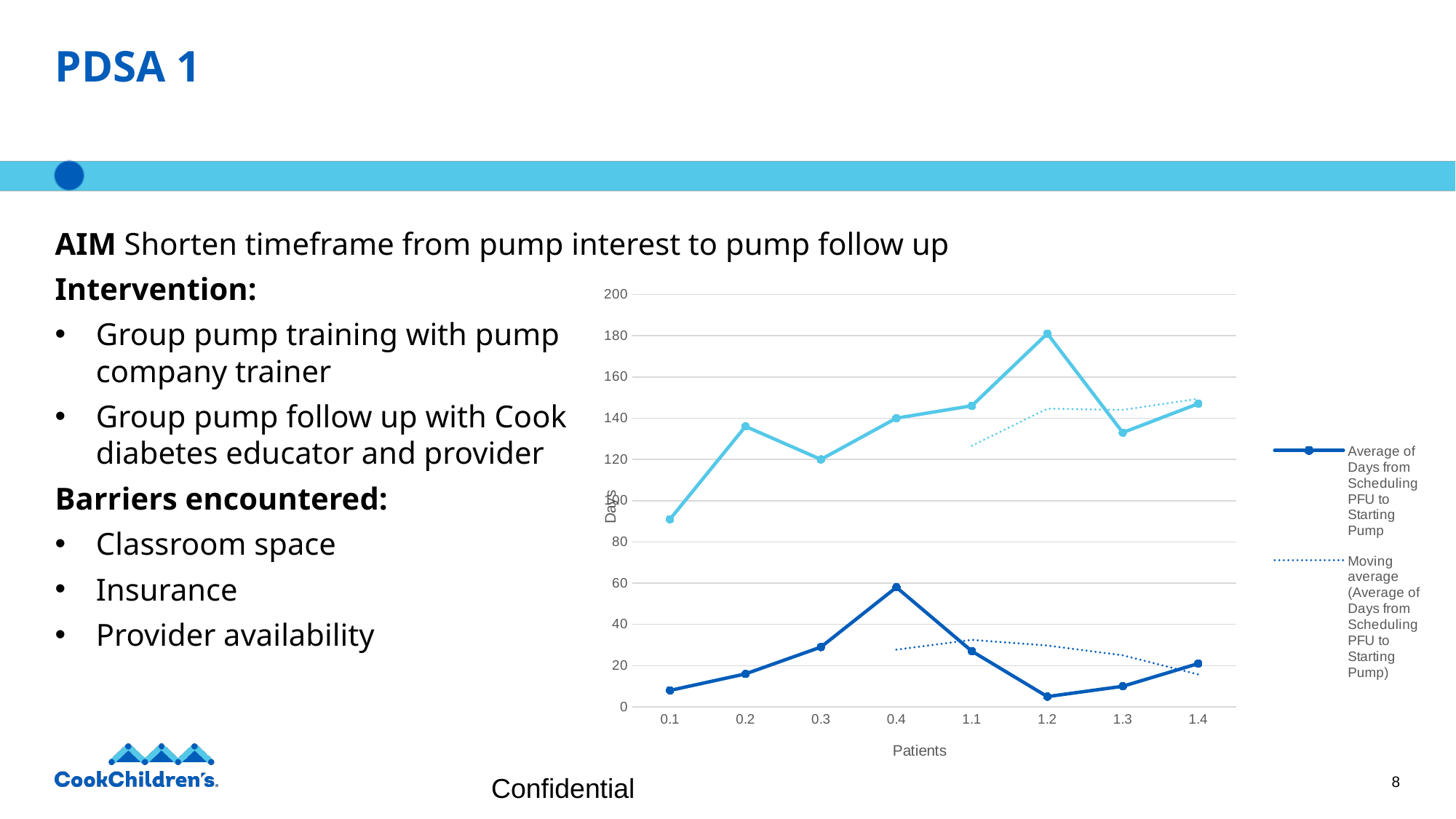
Does the 'Average of Days from Scheduling PFU to Starting Pump' line rise or fall from patient 0.4 to patient 1.2? fall At which patient does the 'Average of Days from Scheduling PFU to Starting Pump' line reach its lowest value? 1.2 At which patient does the 'Average of Days from Scheduling PFU to Starting Pump' line reach its highest value? 0.4 Is the value of the 'Average of Days from Scheduling PFU to Starting Pump' line at patient 1.2 greater or less than 20? less On the 'Average of Days from Scheduling PFU to Starting Pump' line, which is larger: the value at patient 0.2 or at patient 0.3? 0.3 At which patient does the upper light blue line reach its highest value? 1.2 What kind of chart is shown on the slide? line chart Is the value of the upper light blue line at patient 1.2 greater or less than 160? greater What is the title of the x axis? Patients Is the value of the 'Average of Days from Scheduling PFU to Starting Pump' line at patient 0.4 greater or less than 40? greater How many patient points are plotted along the x axis? 8 How many series does the legend list? 2